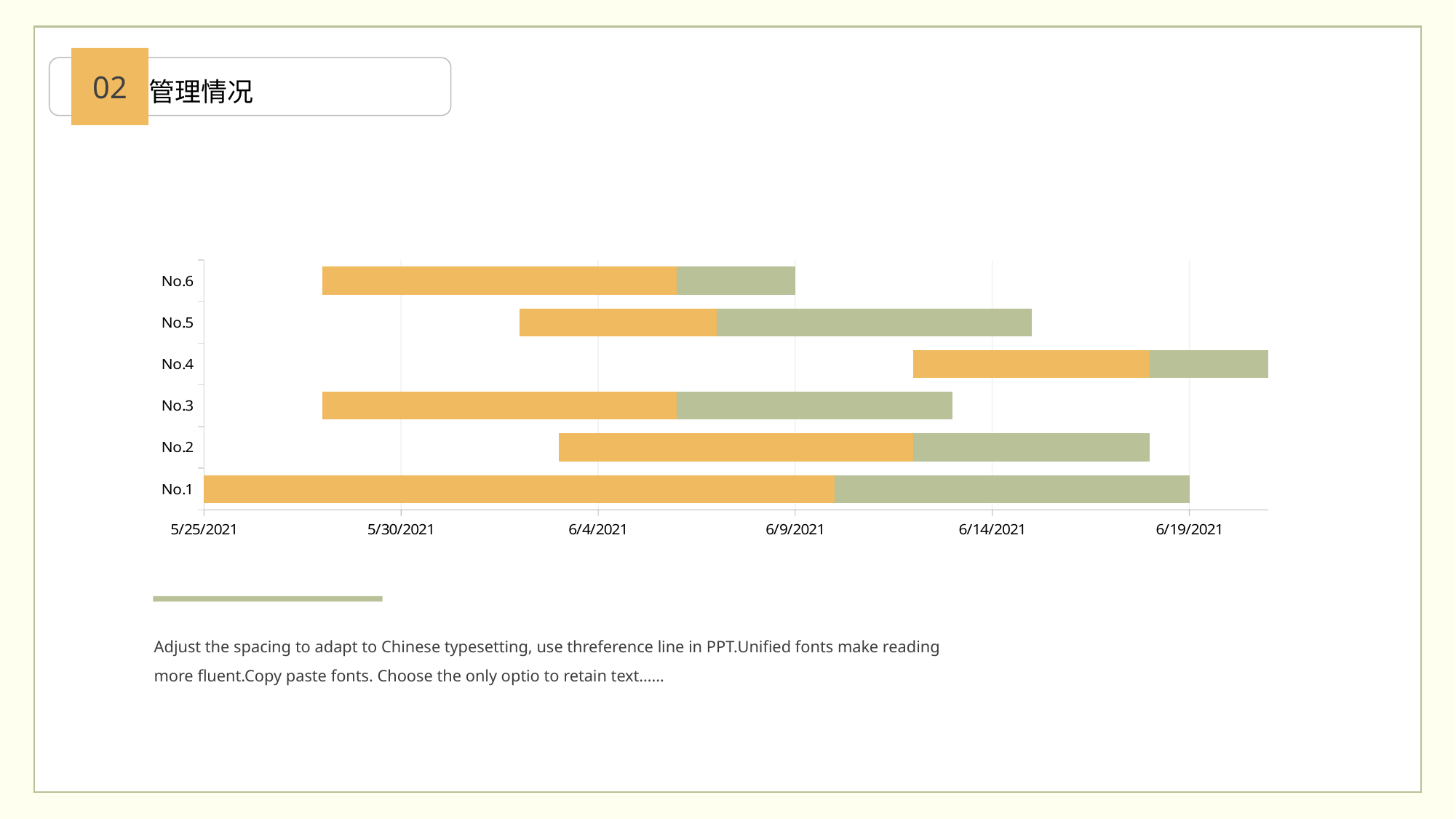
How many categories (tasks) are listed on the vertical axis of the chart? 6 On what date does the bar for No.1 begin? 5/25/2021 Which bar is longer, No.6 or No.1? No.1 Which category has the longest bar overall? No.1 On what date does the bar for No.1 end? 6/19/2021 Does the bar for No.3 end before or after 6/14/2021? before Which category has the shortest bar overall? No.4 Does the bar for No.2 start before or after 6/4/2021? before Does the bar for No.5 end before or after 6/14/2021? after On what date does the bar for No.6 end? 6/9/2021 Which category's bar extends furthest to the right (ends latest)? No.4 What kind of chart is shown on the slide? bar chart